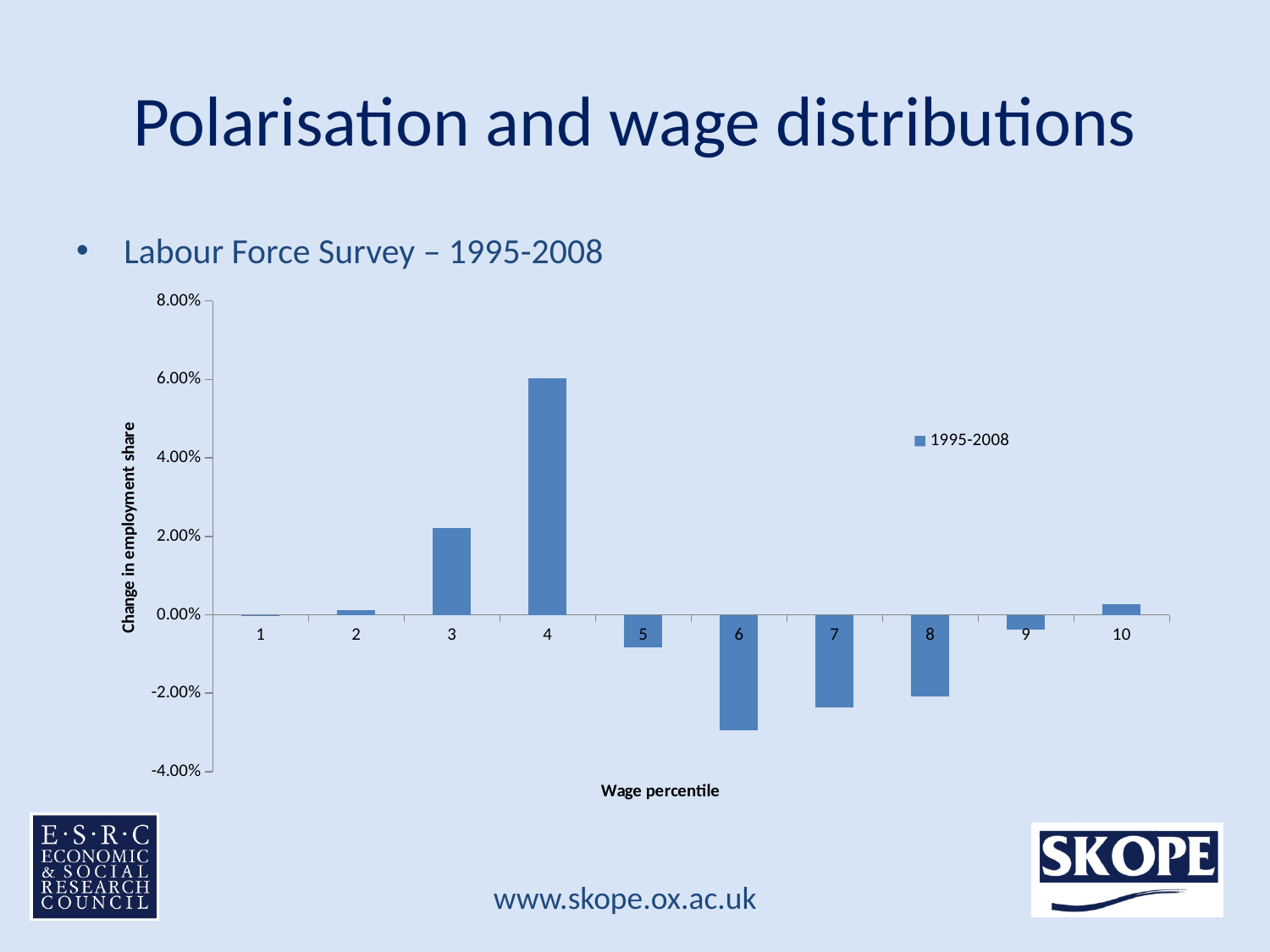
Is the value for wage percentile 4 greater or less than 4.00%? greater Which wage percentile has the highest change in employment share? 4 How many wage percentile categories are plotted on the x axis? 10 Which has the larger change in employment share, wage percentile 6 or wage percentile 9? 9 What is the label of the series shown in the legend? 1995-2008 What kind of chart is shown on the slide? bar chart How many series does the legend list? 1 Which wage percentile has the lowest change in employment share? 6 Is the value for wage percentile 3 greater or less than 2.00%? greater Which has the larger change in employment share, wage percentile 3 or wage percentile 4? 4 Is the value for wage percentile 5 greater or less than 0.00%? less